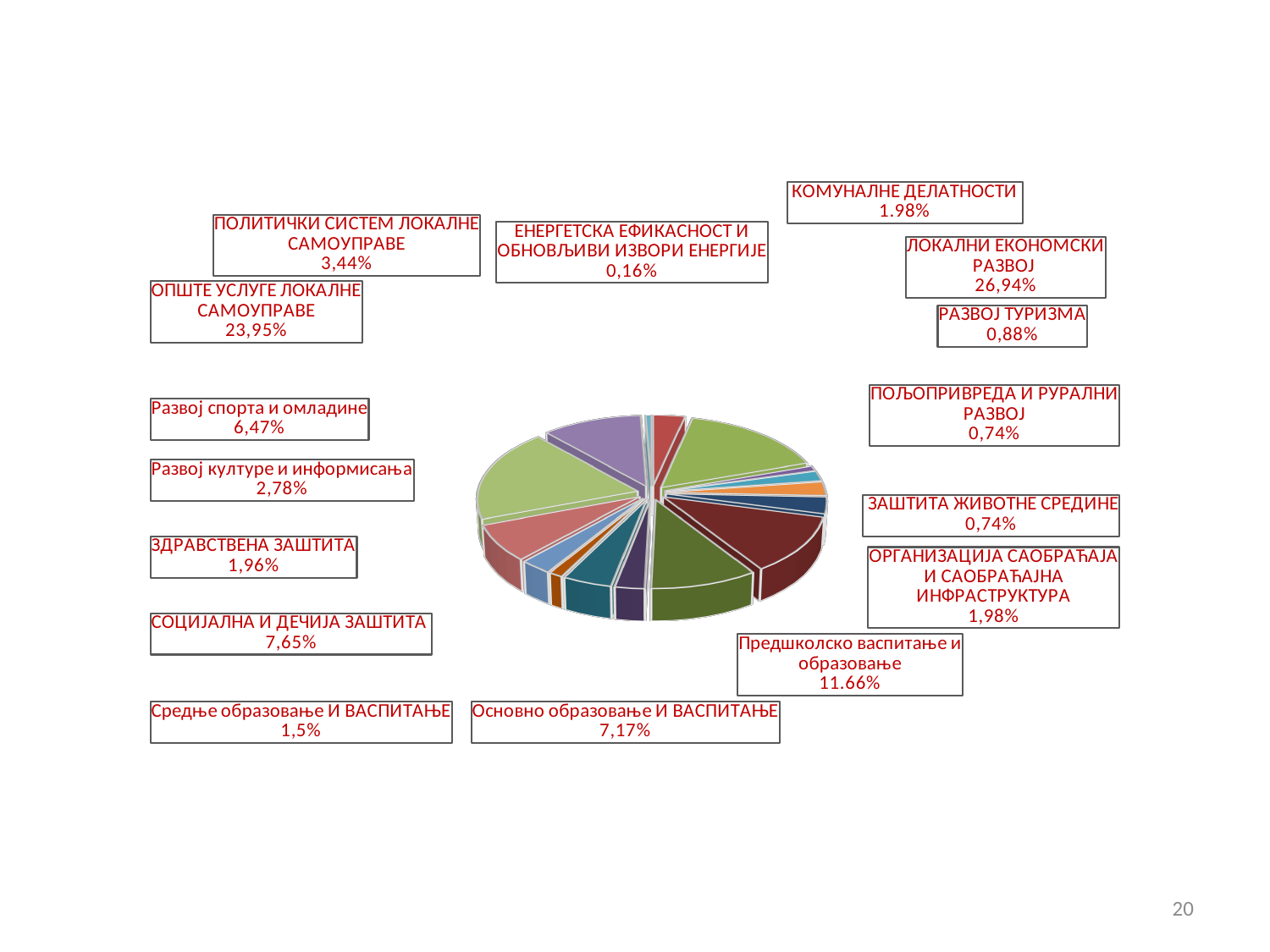
What percentage is shown for Развој културе и информисања? 2,78% What percentage is shown for Предшколско васпитање и образовање? 11.66% What is the difference in percentage points between Предшколско васпитање и образовање and Основно образовање И ВАСПИТАЊЕ? 4,49% Which category has the largest share of the pie? ЛОКАЛНИ ЕКОНОМСКИ РАЗВОЈ What percentage does the slice for ЛОКАЛНИ ЕКОНОМСКИ РАЗВОЈ represent? 26,94% Which category has the smallest share of the pie? ЕНЕРГЕТСКА ЕФИКАСНОСТ И ОБНОВЉИВИ ИЗВОРИ ЕНЕРГИЈЕ What type of chart is shown on the slide? Pie chart What percentage is shown for ОПШТЕ УСЛУГЕ ЛОКАЛНЕ САМОУПРАВЕ? 23,95% How many categories are labelled on the pie chart? 16 Which has a larger share: Развој спорта и омладине or Основно образовање И ВАСПИТАЊЕ? Основно образовање И ВАСПИТАЊЕ What percentage is shown for СОЦИЈАЛНА И ДЕЧИЈА ЗАШТИТА? 7,65% What is the difference in percentage points between ЛОКАЛНИ ЕКОНОМСКИ РАЗВОЈ and ОПШТЕ УСЛУГЕ ЛОКАЛНЕ САМОУПРАВЕ? 2,99%